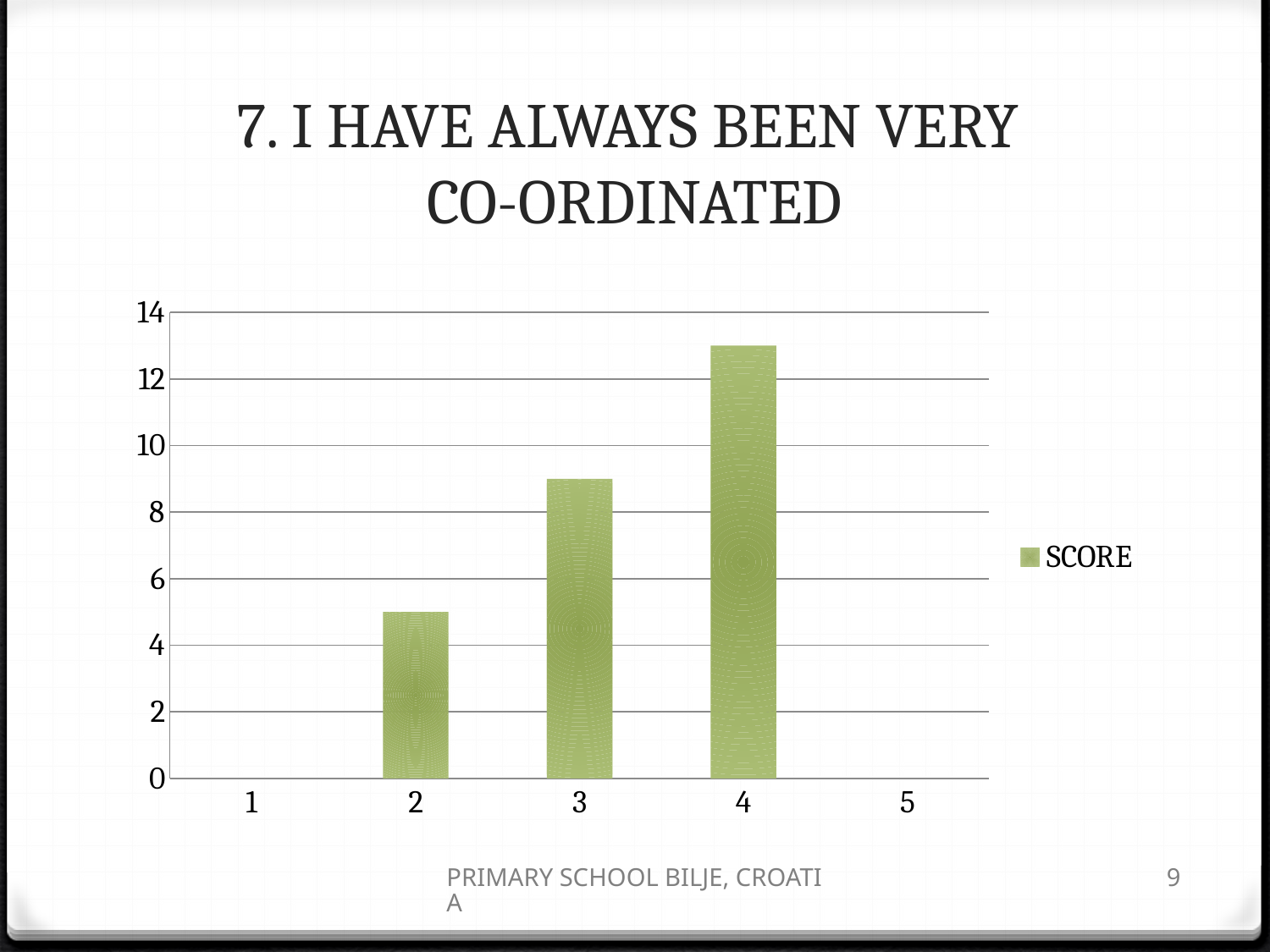
How many series does the legend list? 1 Is the SCORE for category 4 greater or less than 14? less How many categories are shown on the x axis? 5 Is the SCORE for category 2 greater or less than 6? less Is the SCORE for category 2 greater or less than 4? greater Which has a higher SCORE, category 2 or category 3? 3 Which category has the highest SCORE? 4 What kind of chart is shown on the slide? bar chart What is the name of the series shown in the legend? SCORE Do the SCORE values rise or fall from category 2 to category 4? rise